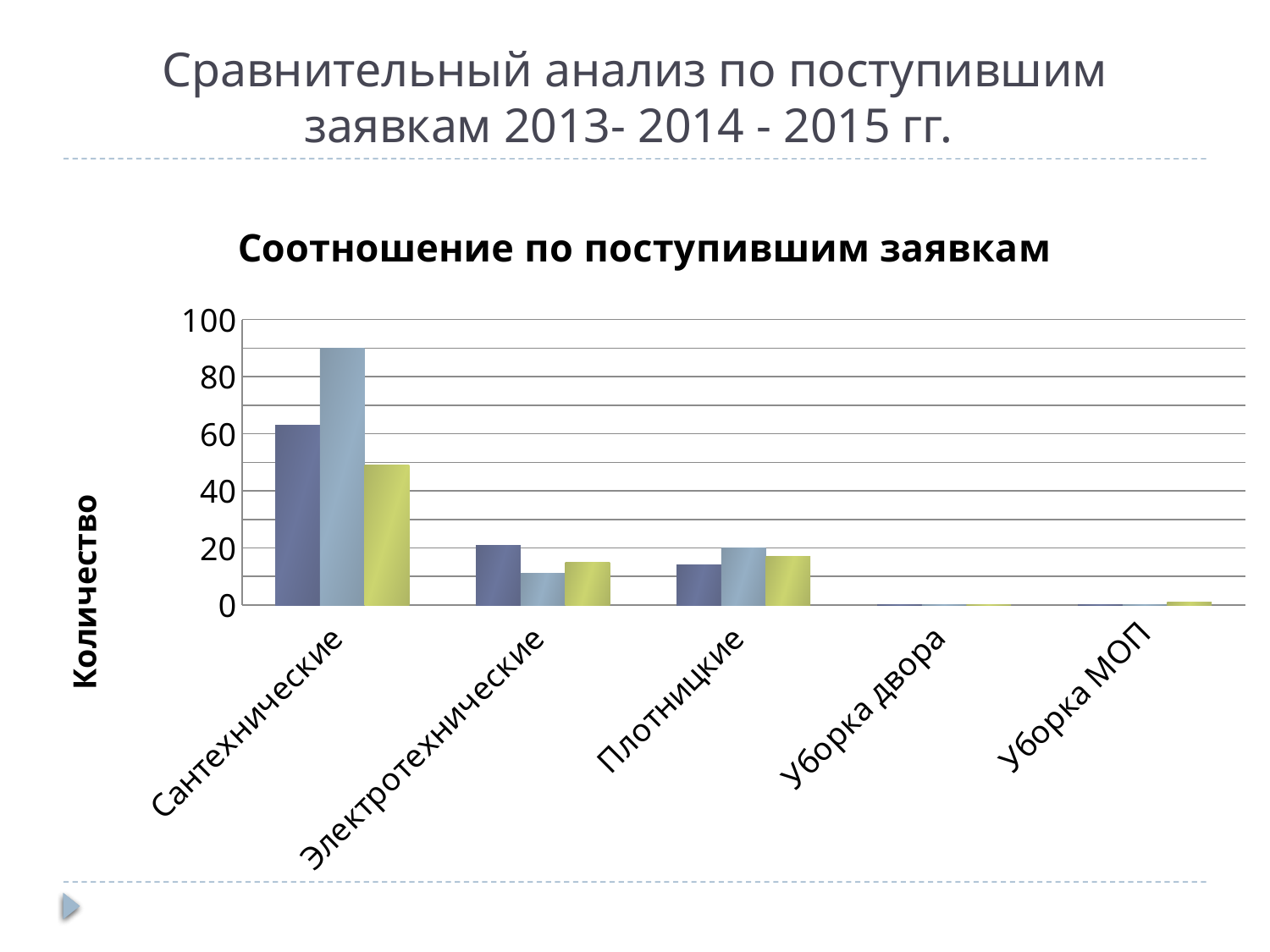
Is the value of the third (yellow-green) bar for Сантехнические greater or less than 60? less What is the title of the chart? Соотношение по поступившим заявкам How many categories are shown on the x axis of the chart? 5 Which category has larger values, Сантехнические or Уборка МОП? Сантехнические Is the value of the first (dark blue) bar for Электротехнические greater or less than 40? less Is the value of the first (dark blue) bar for Сантехнические greater or less than 60? greater Which category has larger values, Сантехнические or Плотницкие? Сантехнические Which category has the tallest bars in the chart? Сантехнические What kind of chart is shown on the slide? bar chart What is the label of the vertical axis? Количество